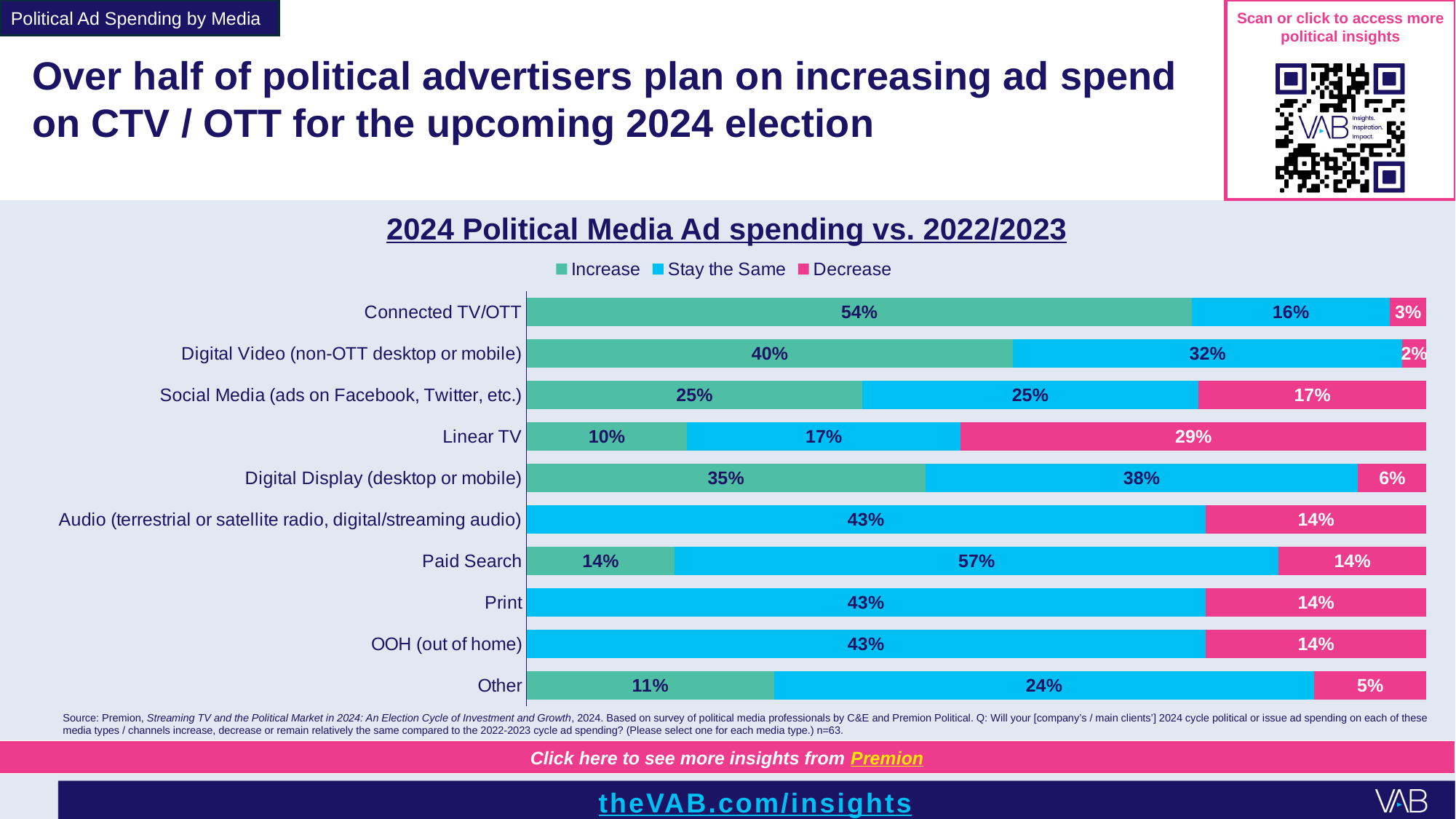
Which media type has the highest Decrease percentage? Linear TV What is the total of the three labelled segments for Connected TV/OTT? 73% Which has a larger Increase value: Social Media or Digital Display? Digital Display (desktop or mobile) What is the Stay the Same value for Paid Search? 57% What is the title of the chart? 2024 Political Media Ad spending vs. 2022/2023 How many series does the legend list? 3 For Digital Video (non-OTT desktop or mobile), how many percentage points higher is Increase than Stay the Same? 8 percentage points What is the Decrease value for Linear TV? 29% Which media type has the highest Increase percentage? Connected TV/OTT What percentage of political advertisers plan to increase ad spend on Connected TV/OTT? 54% How many media types are shown in the chart? 10 What kind of chart is shown on the slide? Stacked bar chart